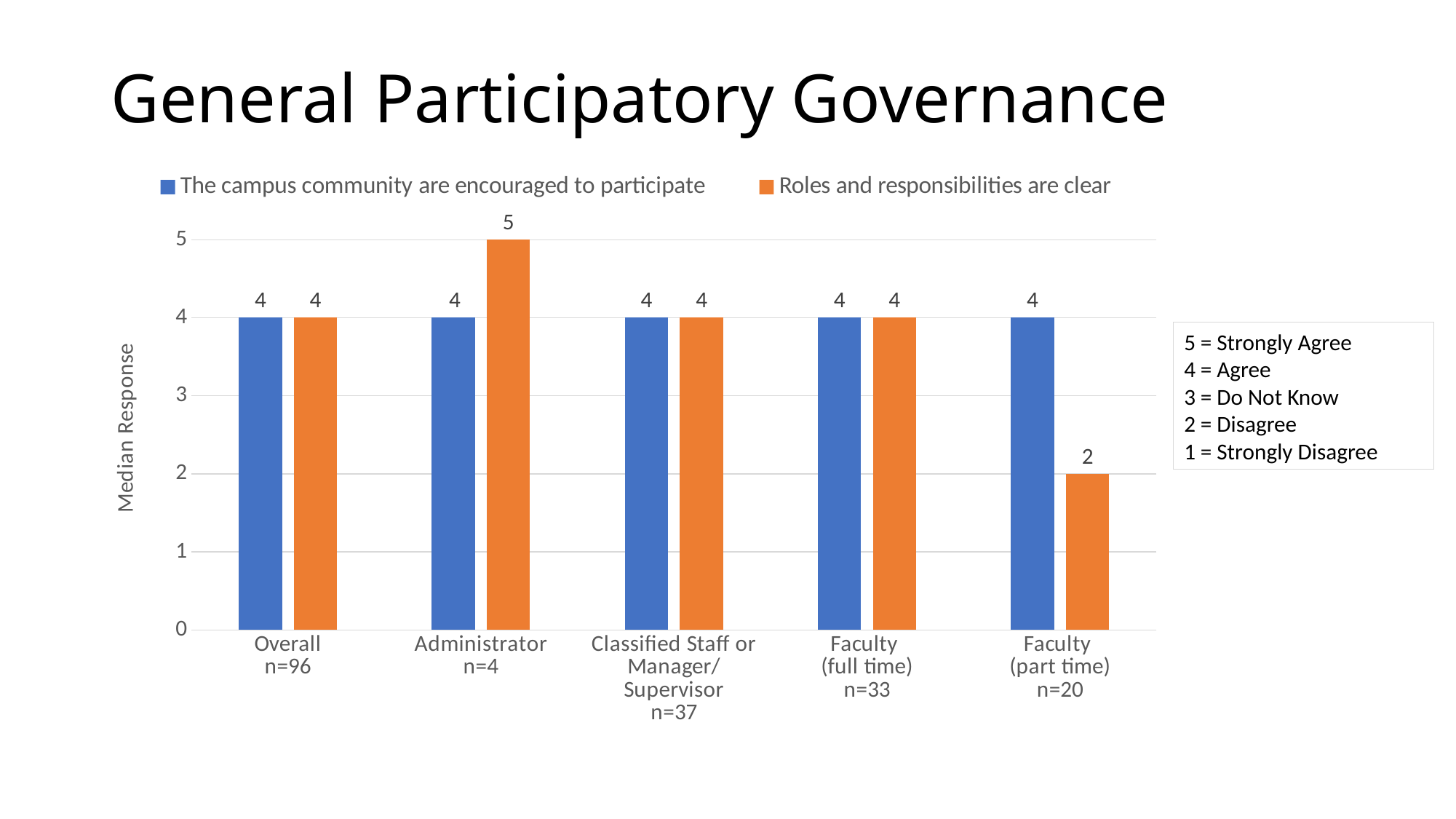
Which group has the lowest median response for 'Roles and responsibilities are clear'? Faculty (part time) What is the median response for 'The campus community are encouraged to participate' for Overall? 4 What is the difference between the two series' median responses for Faculty (part time)? 2 How many groups are shown on the x axis? 5 What kind of chart is shown on the slide? Bar chart For Administrators, which series has the larger median response? Roles and responsibilities are clear What is the median response for 'Roles and responsibilities are clear' among Administrators? 5 How many series does the legend list? 2 Which group has the highest median response for 'Roles and responsibilities are clear'? Administrator What is the median response for 'Roles and responsibilities are clear' among Faculty (part time)? 2 What is the label of the vertical axis? Median Response What is the sample size (n) for the Classified Staff or Manager/Supervisor group? n=37